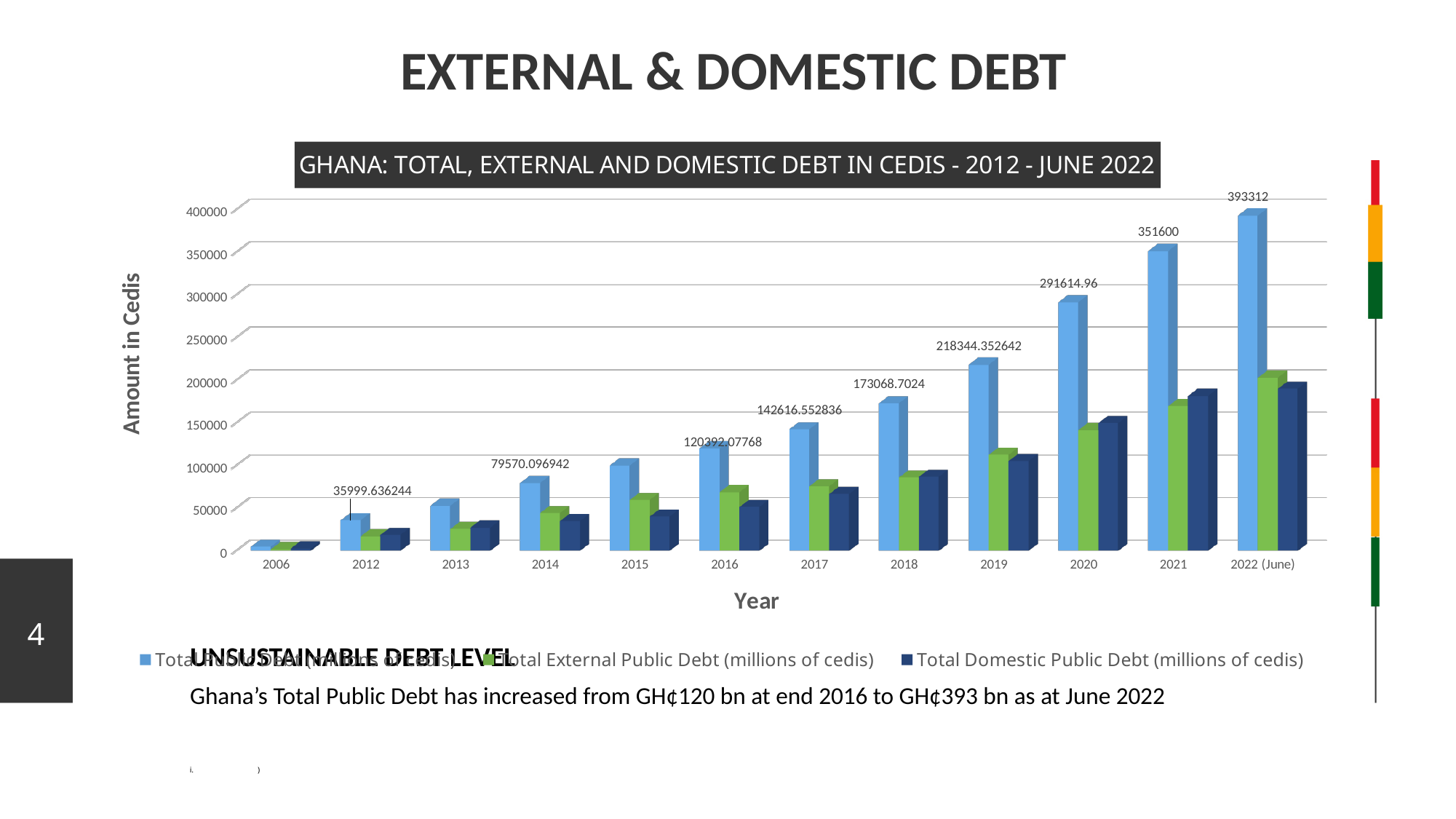
What is the Total Public Debt value shown for 2022 (June)? 393312 How many series does the legend list? 3 What is the Total Public Debt value shown for 2012? 35999.636244 What is the Total Public Debt value shown for 2021? 351600 Which year has the highest Total Public Debt? 2022 (June) Is the Total External Public Debt for 2022 (June) greater or less than 150000? greater What is the Total Public Debt value shown for 2020? 291614.96 By how much did Total Public Debt increase from 2021 to 2022 (June)? 41712 What kind of chart is shown on the slide? Bar chart Which year has the lowest Total Public Debt? 2006 Which year has the larger Total Public Debt, 2017 or 2018? 2018 How many years are shown on the x axis? 12